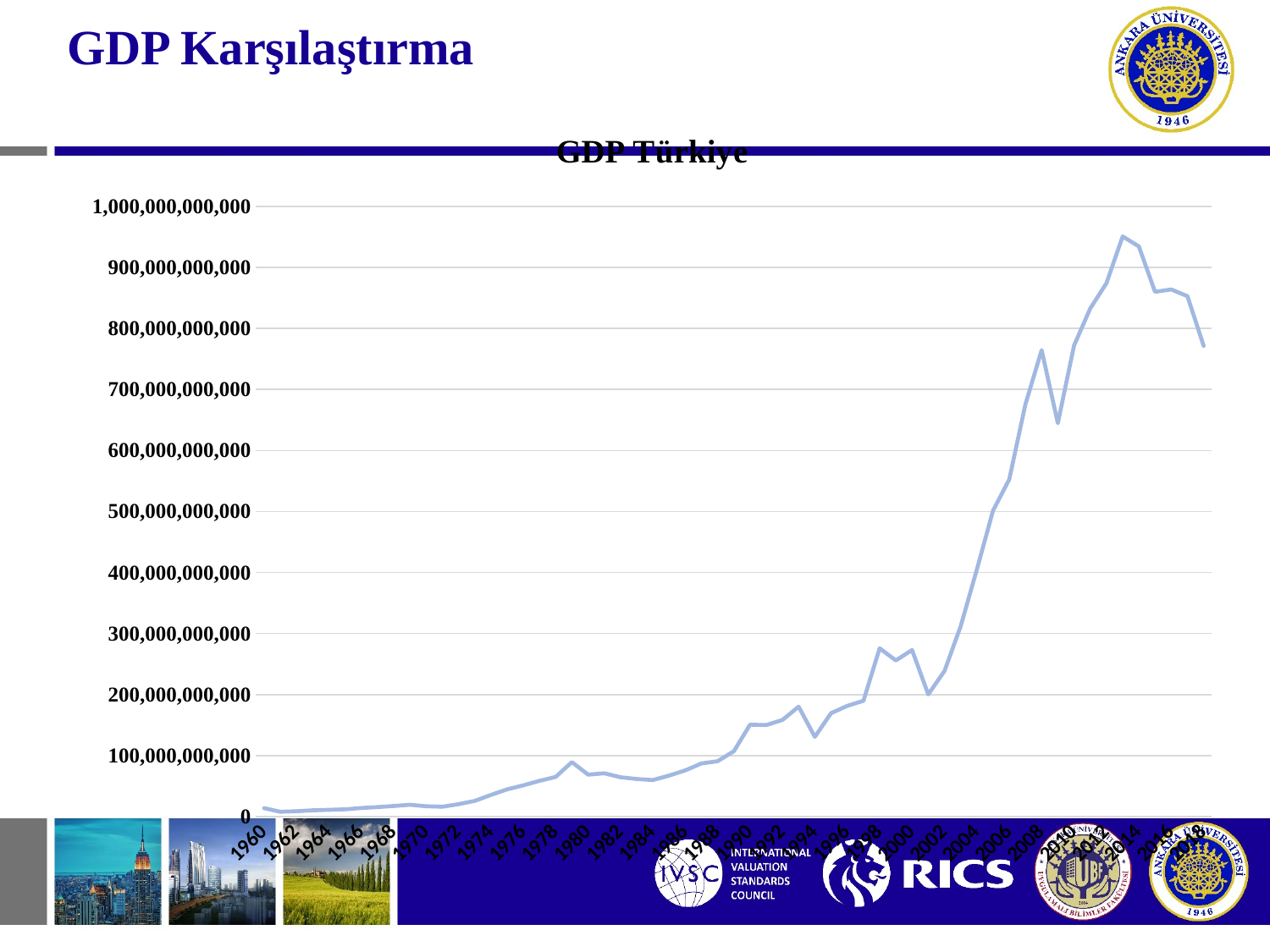
What is the highest value shown on the vertical axis of the chart? 1,000,000,000,000 Which year has the higher GDP value, 2012 or 2014? 2014 Is the GDP value for 1980 greater or less than 100,000,000,000? less Is the GDP value for 2000 greater or less than 200,000,000,000? greater Overall, does the GDP line rise or fall from 1960 to 2018? rise What kind of chart is shown on the slide? line chart Does the GDP line rise or fall between 2014 and 2018? fall What is the title of the chart? GDP Türkiye Is the GDP value for 2018 greater or less than 800,000,000,000? less